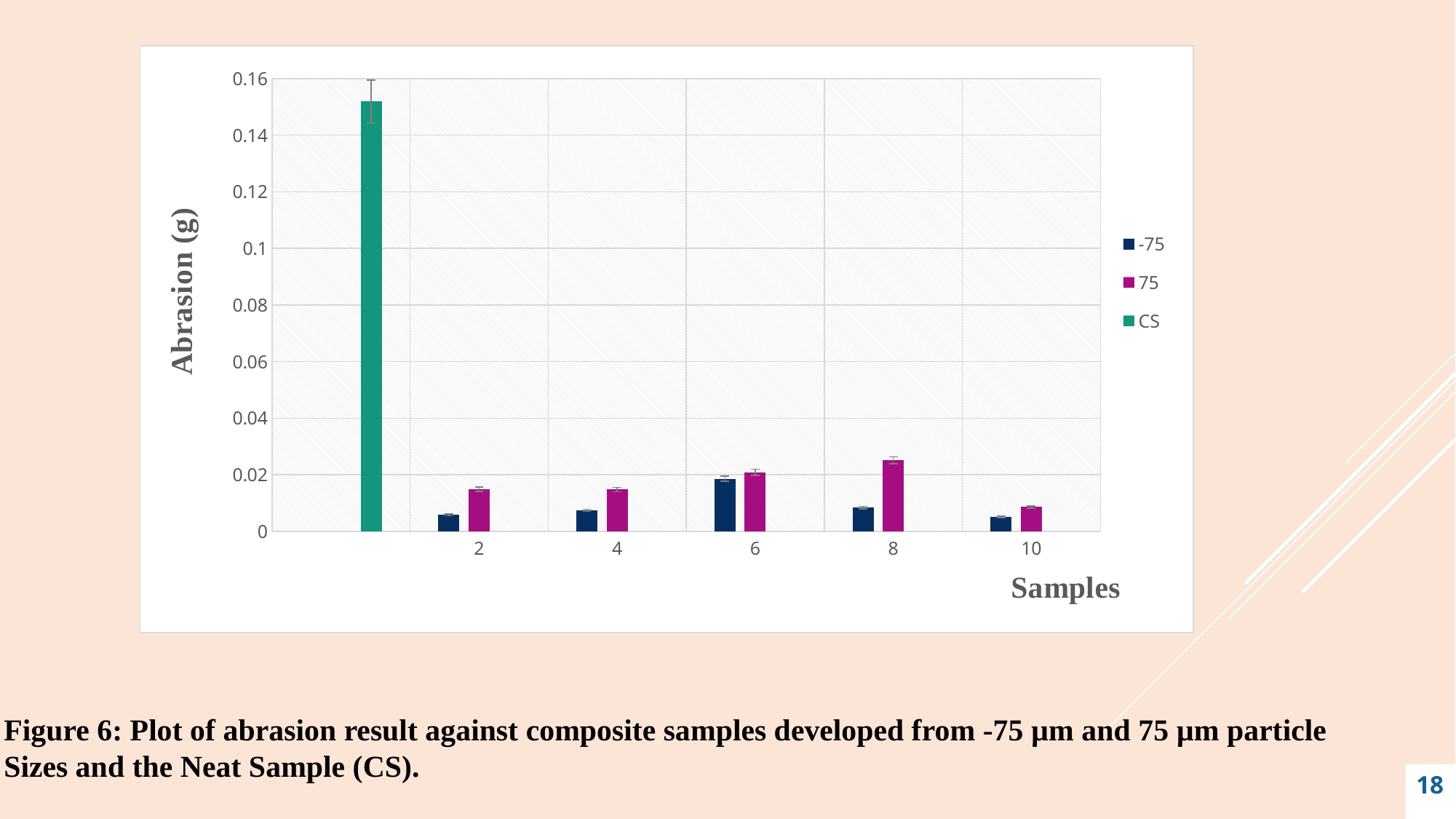
How many series does the legend list? 3 Is the value of the CS bar greater or less than 0.14? greater For the 75 series, at which sample is the abrasion value highest? 8 What kind of chart is shown on the slide? bar chart What are the three series named in the legend? -75, 75, CS At sample 2, which series has the larger value, -75 or 75? 75 What is the title of the vertical axis? Abrasion (g) How many numbered sample categories are labelled on the x axis? 5 Is the value of the CS bar greater or less than 0.16? less Is the value of the 75 series at sample 8 greater or less than 0.02? greater Which series has the tallest bar in the chart? CS